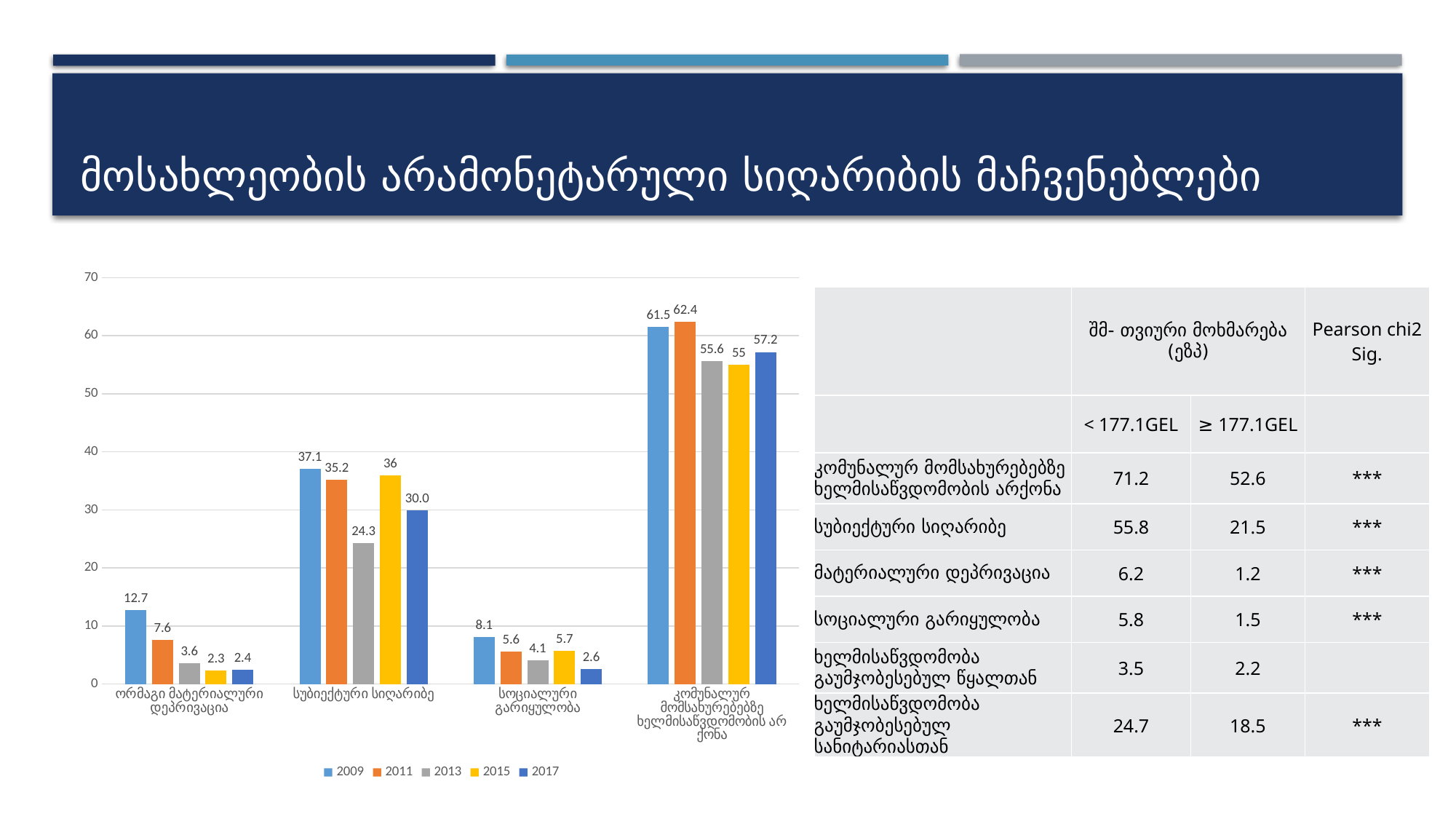
What is the difference between the 2009 and 2017 values for ორმაგი მატერიალური დეპრივაცია in the chart? 10.3 What type of chart is shown on the left of the slide? bar chart What is the 2017 value for კომუნალურ მომსახურებებზე ხელმისაწვდომობის არ ქონა in the chart? 57.2 What is the 2009 value for სუბიექტური სიღარიბე in the chart? 37.1 Which colour represents the 2015 series in the chart legend? yellow Does the 2009 value for ორმაგი მატერიალური დეპრივაცია in the chart rise or fall from 2009 to 2017? fall In the chart, which is larger for სუბიექტური სიღარიბე: the 2011 value or the 2015 value? 2015 Which year has the highest value for კომუნალურ მომსახურებებზე ხელმისაწვდომობის არ ქონა in the chart? 2011 Which year has the lowest value for სოციალური გარიყულობა in the chart? 2017 What is the 2013 value for ორმაგი მატერიალური დეპრივაცია in the chart? 3.6 How many categories are shown on the x axis of the chart? 4 How many series does the chart legend list? 5